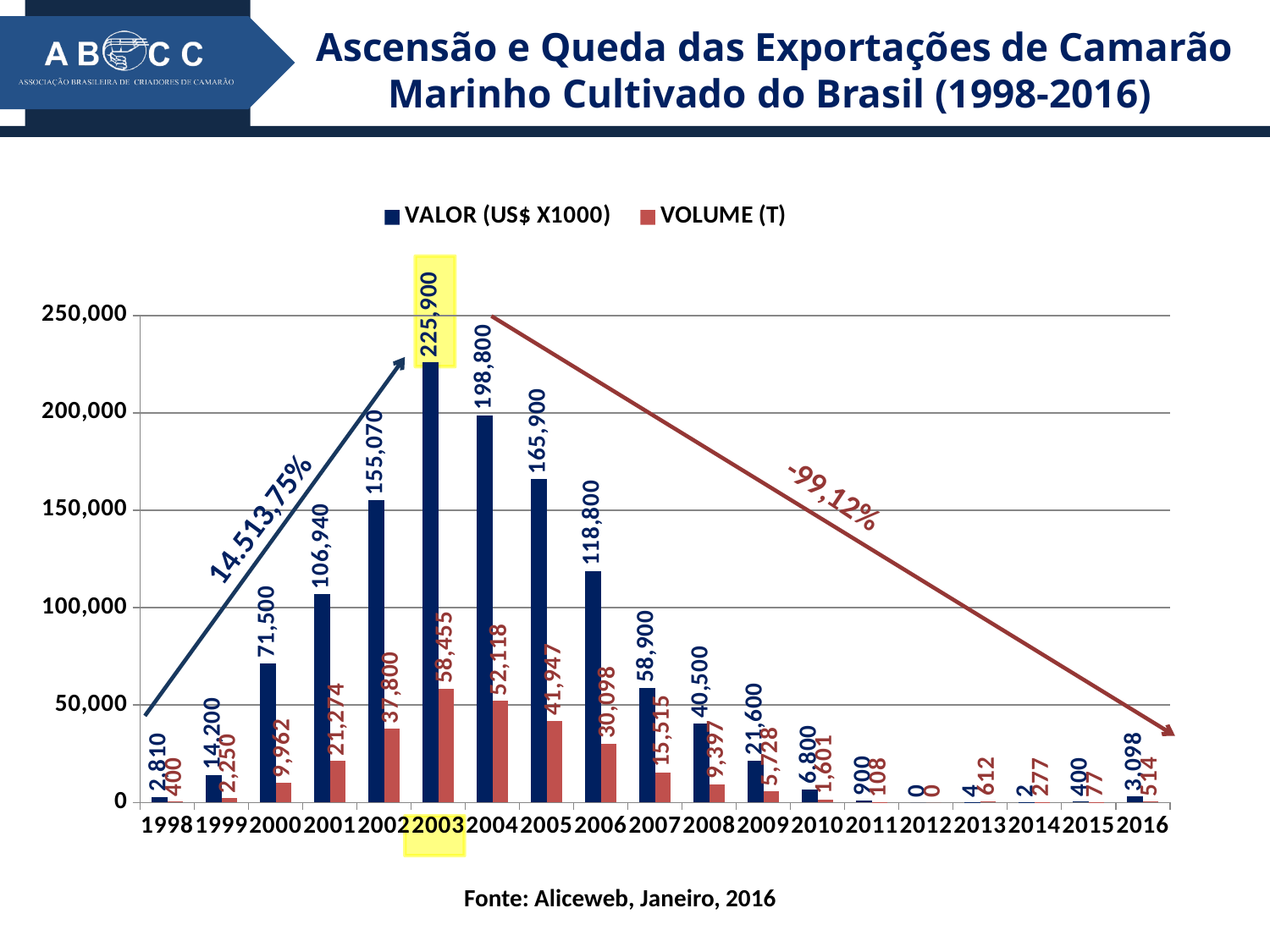
How many years are shown on the x axis? 19 Does the VALOR (US$ X1000) rise or fall from 2003 to 2010? fall Which year has the larger VALOR (US$ X1000), 2002 or 2005? 2005 How many series does the legend list? 2 Is the VALOR (US$ X1000) for 2006 greater or less than 100,000? greater What is the VALOR (US$ X1000) for 2003? 225,900 What kind of chart is shown on the slide? bar chart What is the VOLUME (T) for 2004? 52,118 What is the VALOR (US$ X1000) for 2000? 71,500 What is the difference between the VALOR (US$ X1000) for 2003 and 2004? 27,100 Which year has the highest VOLUME (T)? 2003 Which year has the highest VALOR (US$ X1000)? 2003